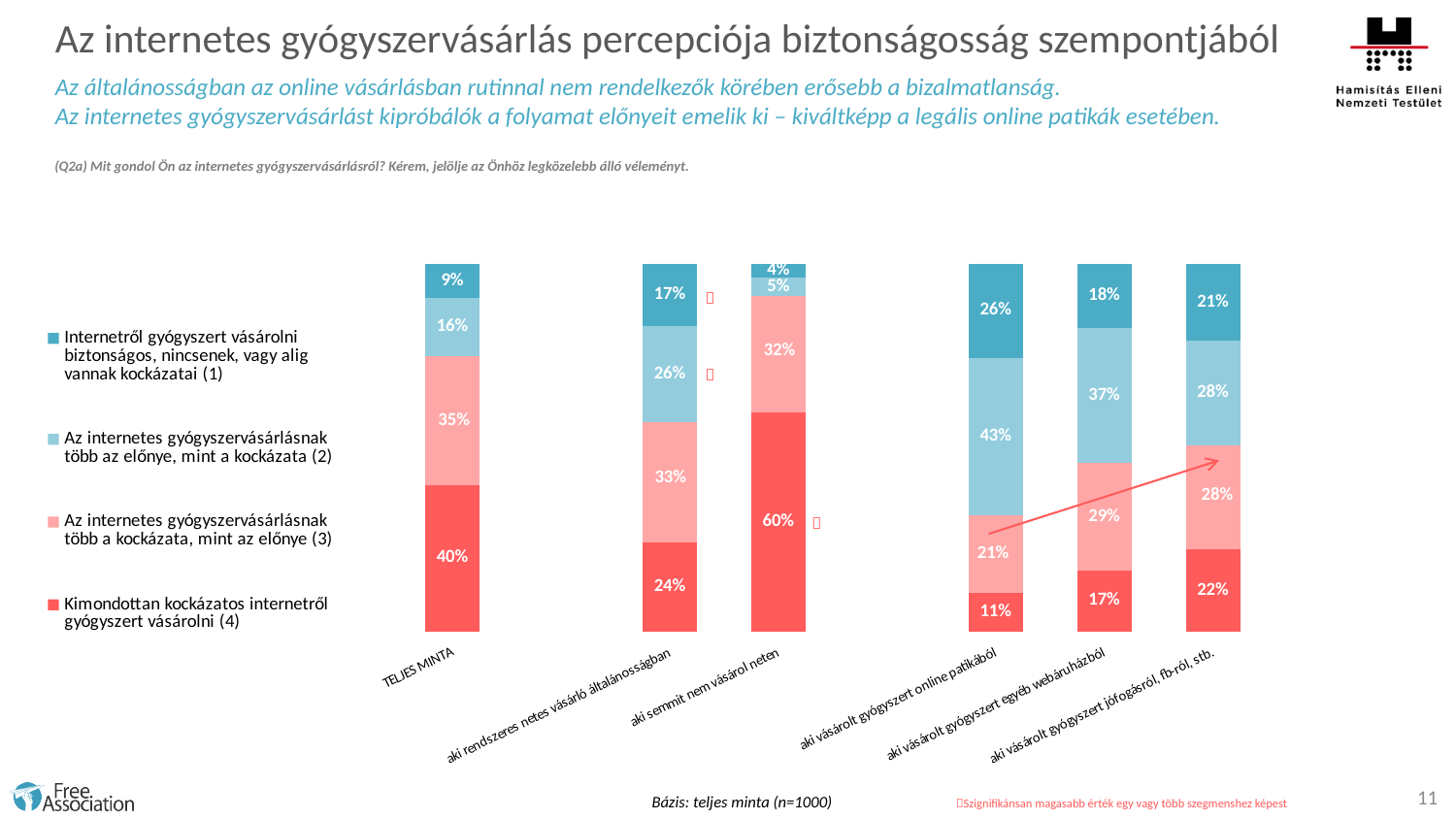
What is the base (Bázis) stated at the bottom of the slide? teljes minta (n=1000) What is the difference between the 'Kimondottan kockázatos internetről gyógyszert vásárolni (4)' values for TELJES MINTA and 'aki vásárolt gyógyszert online patikából'? 29% How many categories are shown along the x axis? 6 Which is larger: the 'Internetről gyógyszert vásárolni biztonságos, nincsenek, vagy alig vannak kockázatai (1)' value for 'aki vásárolt gyógyszert online patikából' or for 'aki vásárolt gyógyszert egyéb webáruházból'? aki vásárolt gyógyszert online patikából What is the value of 'Kimondottan kockázatos internetről gyógyszert vásárolni (4)' for 'aki semmit nem vásárol neten'? 60% How many series does the legend list? 4 Which category has the highest value for 'Kimondottan kockázatos internetről gyógyszert vásárolni (4)'? aki semmit nem vásárol neten What kind of chart is shown on the slide? stacked bar chart Which category has the lowest value for 'Internetről gyógyszert vásárolni biztonságos, nincsenek, vagy alig vannak kockázatai (1)'? aki semmit nem vásárol neten What is the value of 'Kimondottan kockázatos internetről gyógyszert vásárolni (4)' for TELJES MINTA? 40% What is the value of 'Az internetes gyógyszervásárlásnak több az előnye, mint a kockázata (2)' for 'aki vásárolt gyógyszert online patikából'? 43% What is the value of 'Az internetes gyógyszervásárlásnak több a kockázata, mint az előnye (3)' for 'aki rendszeres netes vásárló általánosságban'? 33%